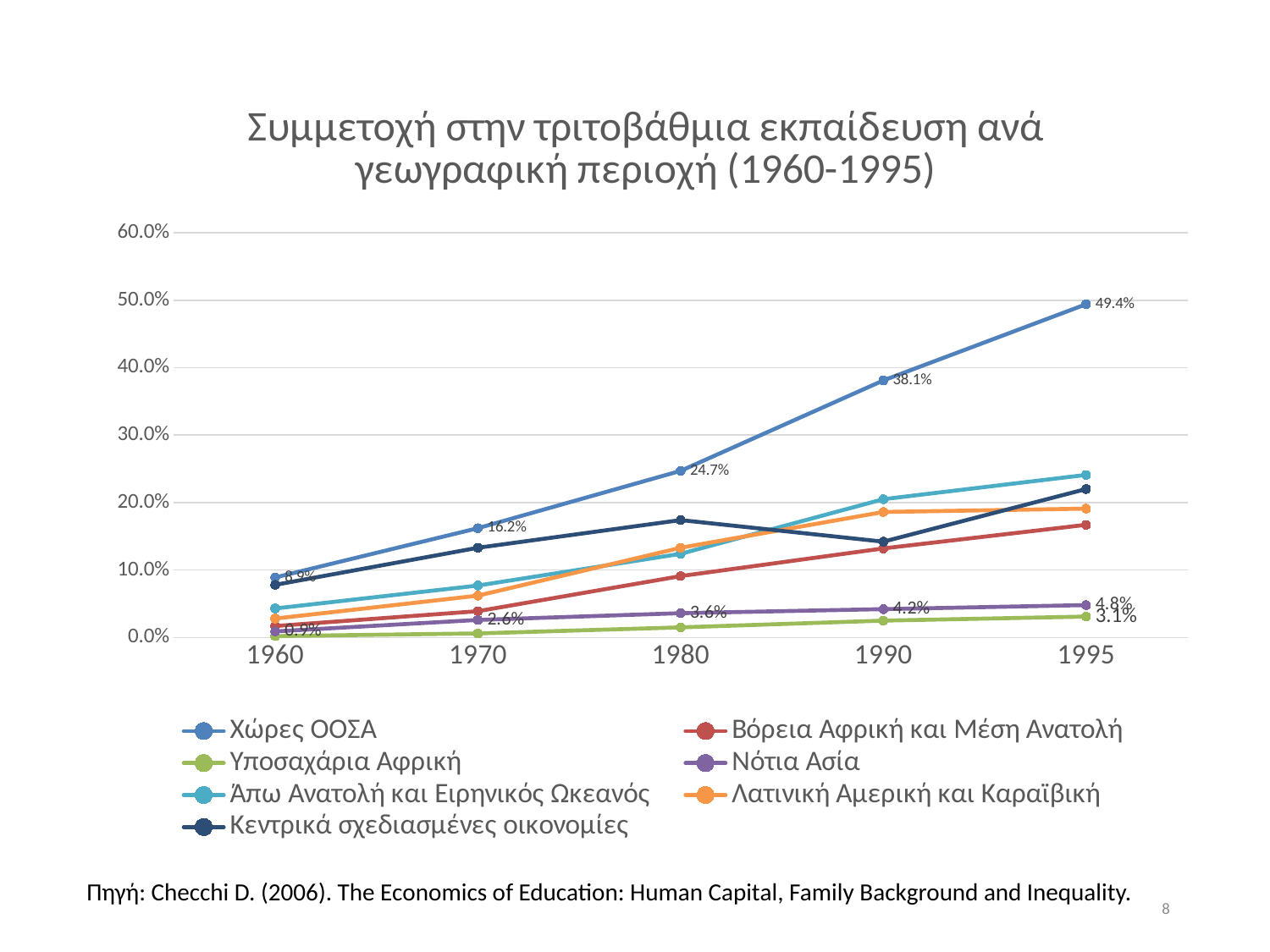
What is the value for Νότια Ασία in 1995? 4.8% What is the value for Υποσαχάρια Αφρική in 1995? 3.1% How many series does the legend list? 7 What is the value for Χώρες ΟΟΣΑ in 1995? 49.4% What kind of chart is shown on the slide? line chart What is the value for Χώρες ΟΟΣΑ in 1990? 38.1% By how many percentage points did the value for Χώρες ΟΟΣΑ increase from 1990 to 1995? 11.3 How many years are shown on the x axis? 5 Is the value for Άπω Ανατολή και Ειρηνικός Ωκεανός in 1995 greater or less than 20%? greater Which series has the highest value in 1995? Χώρες ΟΟΣΑ Which series has the lowest value in 1995? Υποσαχάρια Αφρική What is the value for Χώρες ΟΟΣΑ in 1980? 24.7%